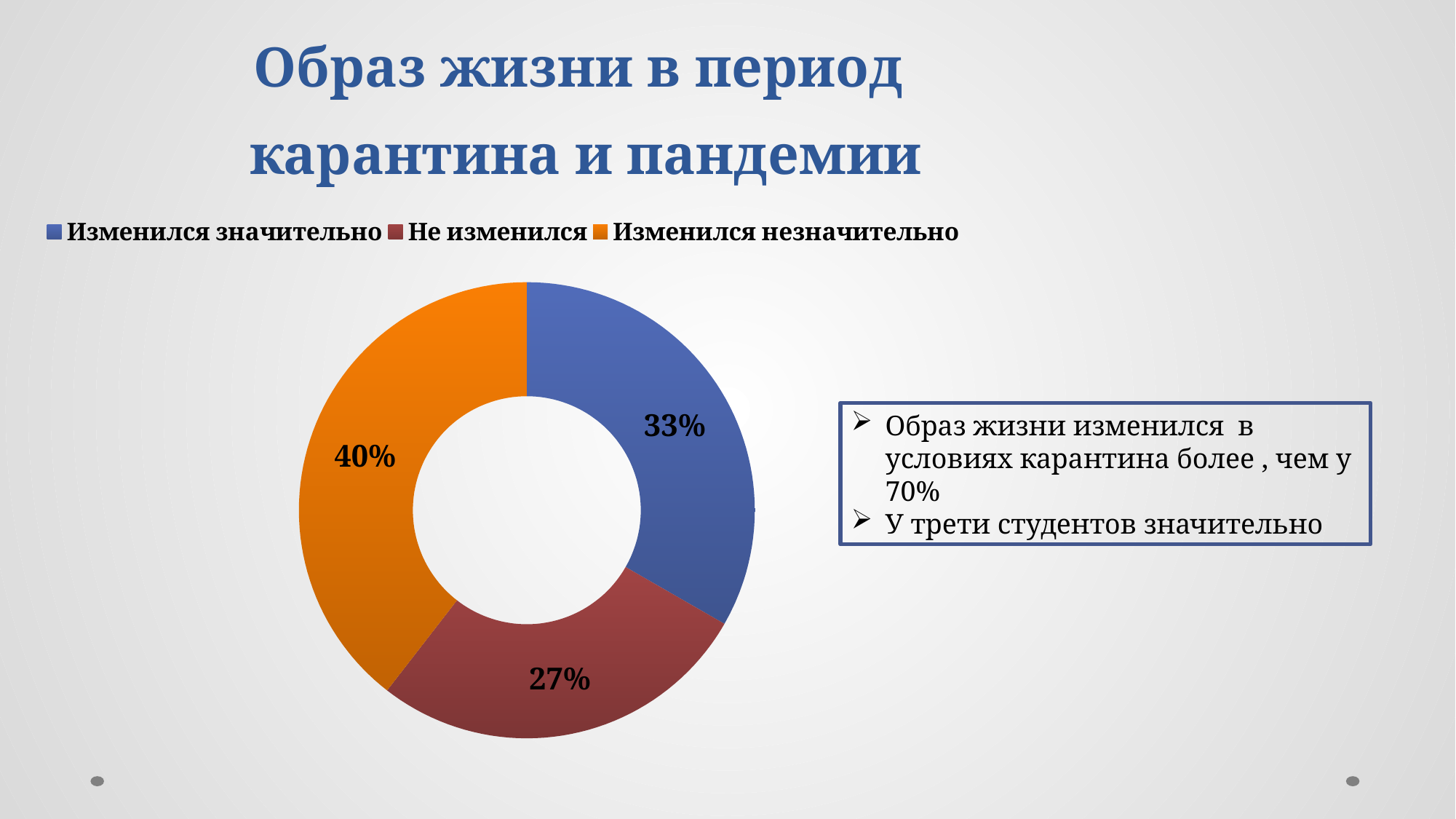
What colour is the slice for 'Не изменился'? Red How many categories does the chart show? 3 Which category has the largest share of the chart? Изменился незначительно What is the difference in percentage points between 'Изменился незначительно' and 'Не изменился'? 13 What kind of chart is shown on the slide? Doughnut chart Which category has the smallest share of the chart? Не изменился Which is larger: the share for 'Изменился значительно' or the share for 'Изменился незначительно'? Изменился незначительно What is the combined share of 'Изменился значительно' and 'Изменился незначительно'? 73% What is the difference in percentage points between 'Изменился значительно' and 'Не изменился'? 6 What share of the chart does 'Изменился незначительно' represent? 40% What share of the chart does 'Не изменился' represent? 27% What share of the chart does 'Изменился значительно' represent? 33%